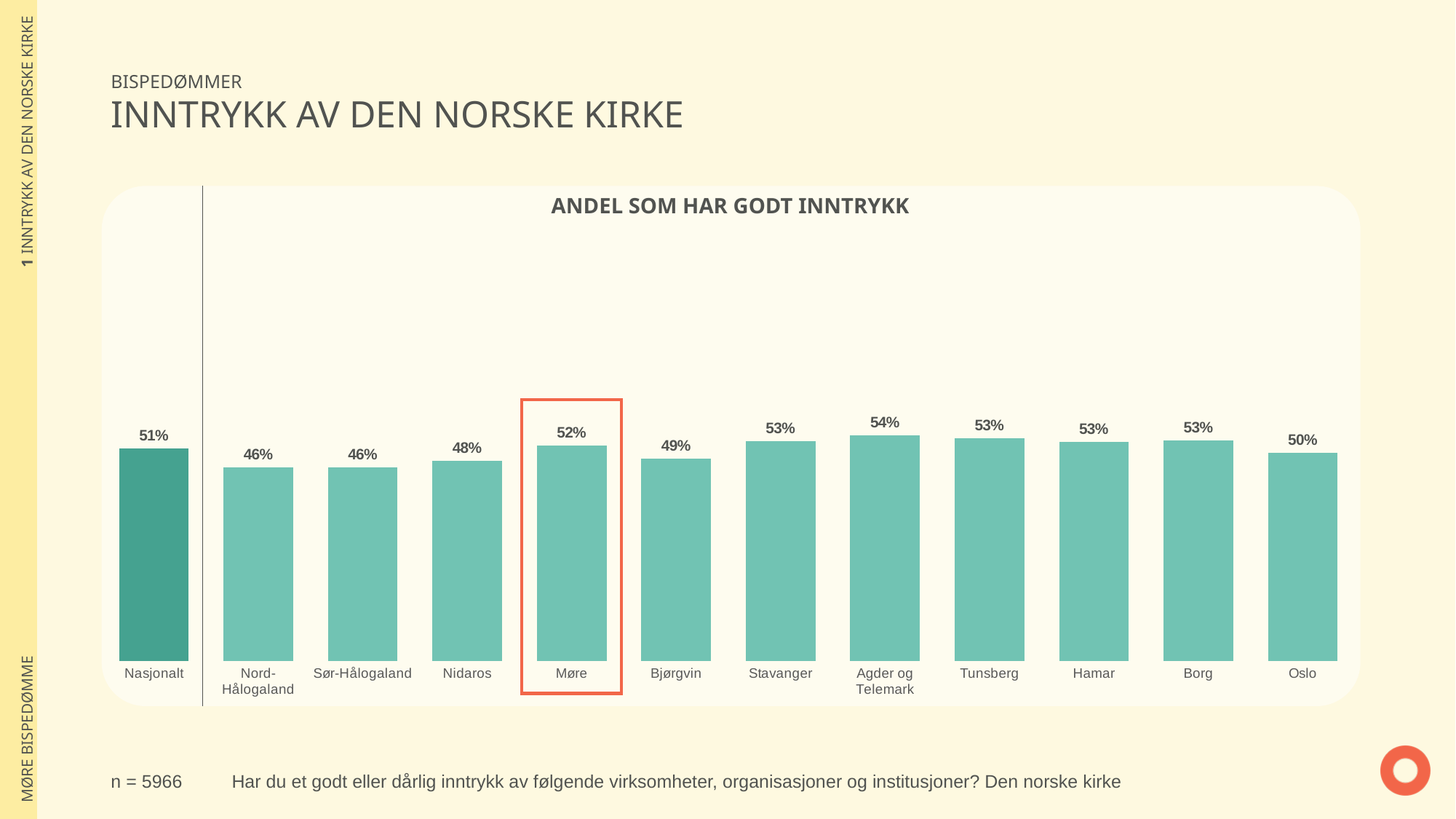
What is the value for Møre in the chart? 52% What is the value for Nidaros in the chart? 48% What is the difference between the values for Agder og Telemark and Nord-Hålogaland? 8 percentage points What is the title of the chart? ANDEL SOM HAR GODT INNTRYKK What is the difference between the values for Møre and Nasjonalt? 1 percentage point Which is larger, the value for Bjørgvin or the value for Stavanger? Stavanger Which category has the highest value in the chart? Agder og Telemark What is the lowest value shown in the chart? 46% What is the value for Nasjonalt in the chart? 51% What is the value for Oslo in the chart? 50% What kind of chart is shown on the slide? Bar chart How many categories are shown in the chart? 12